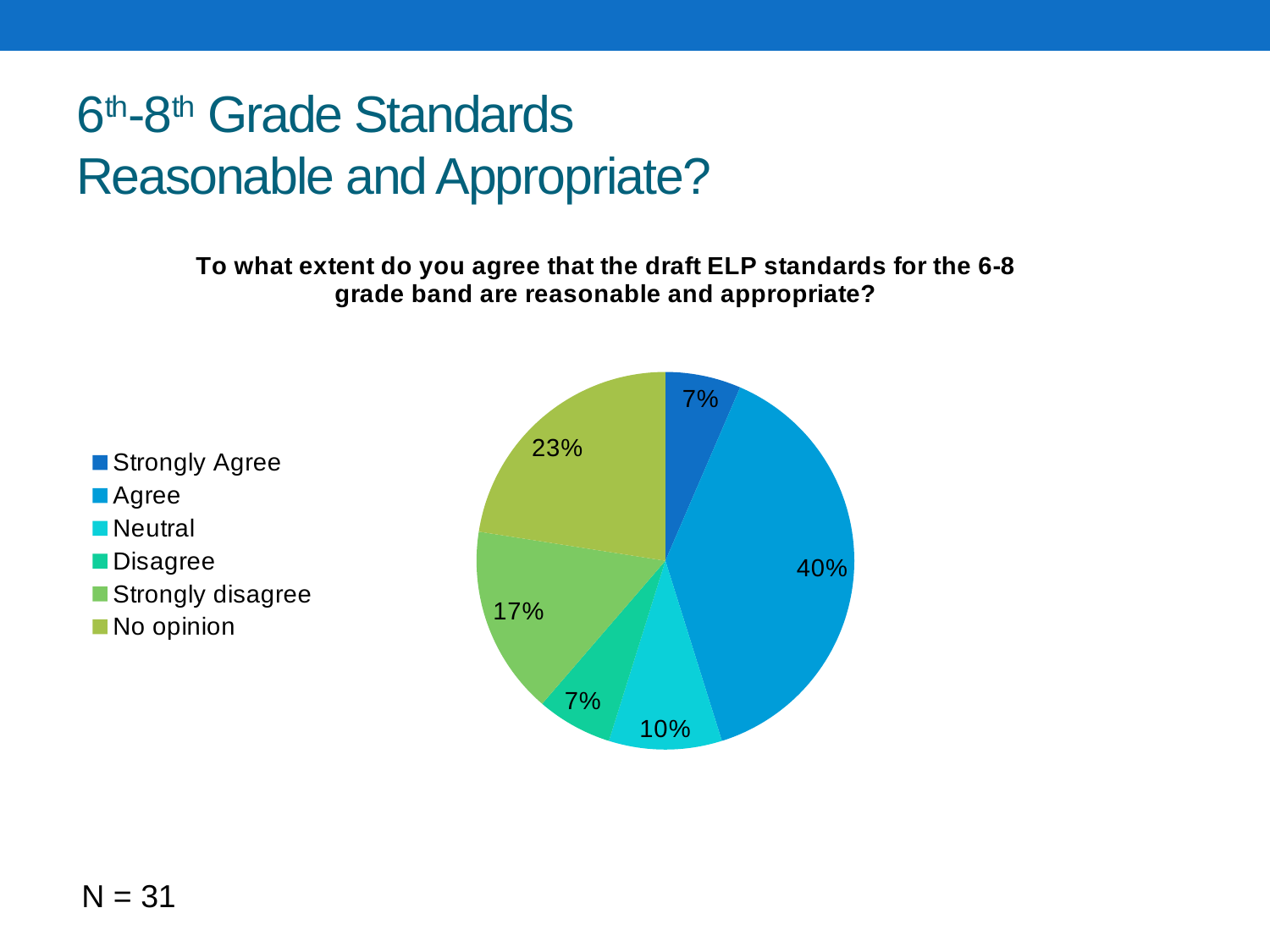
What percentage of respondents chose Neutral? 10% Which is larger, the share for Strongly disagree or the share for Neutral? Strongly disagree What percentage of respondents chose Strongly disagree? 17% What is the difference between the Agree share and the No opinion share? 17% Which response category has the largest share of the pie? Agree Which legend entry is shown in the darkest blue colour? Strongly Agree What kind of chart is shown on the slide? Pie chart What is the sample size (N) stated on the slide? N = 31 What is the combined share of Strongly Agree and Agree? 47% How many response categories does the legend list? 6 What percentage of respondents chose No opinion? 23% What percentage of respondents chose Agree? 40%